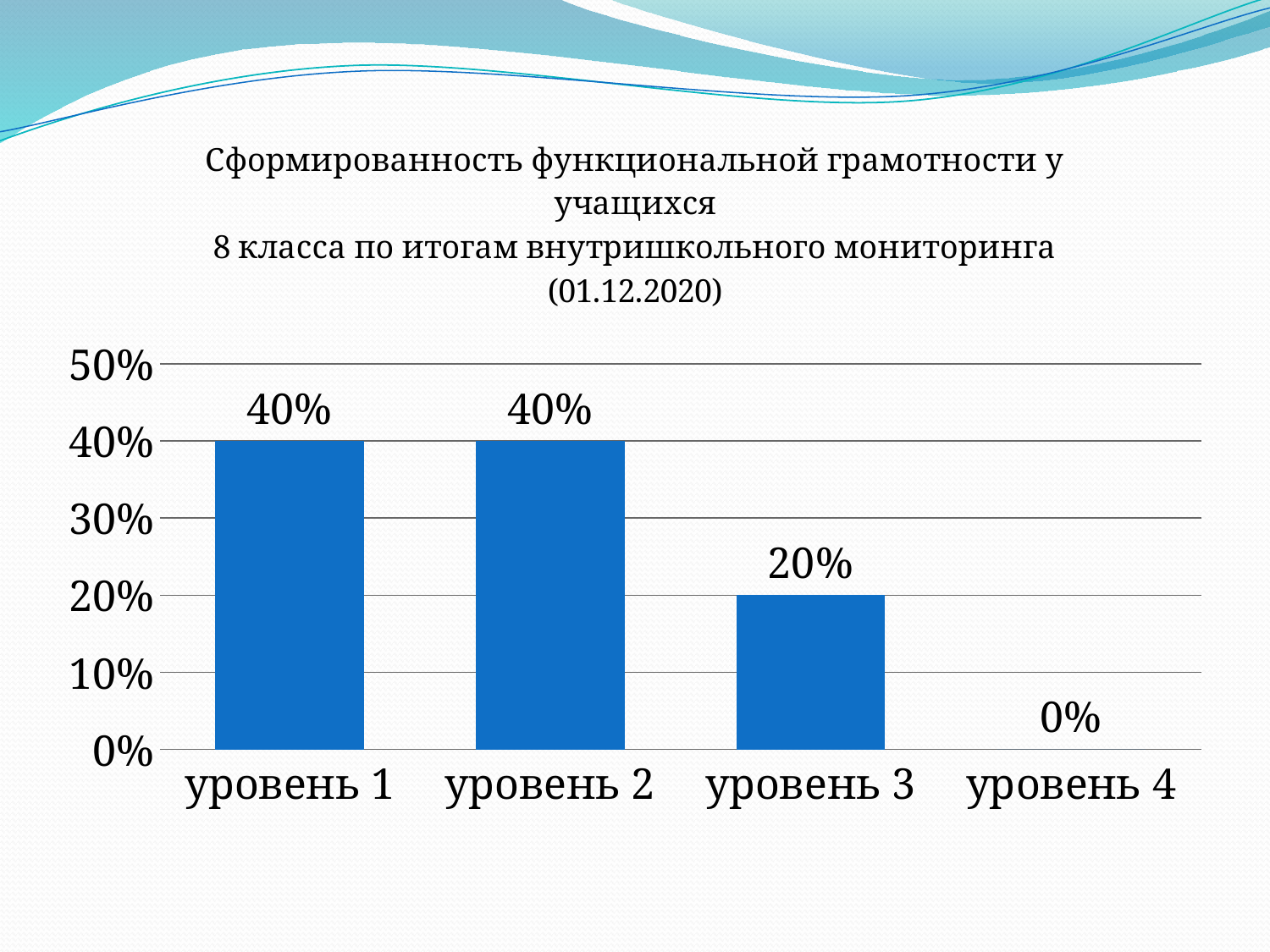
What is the highest value shown on the y axis? 50% Which is larger, the value for уровень 1 or the value for уровень 3? уровень 1 What date is given in the chart title? 01.12.2020 What is the difference between the values for уровень 2 and уровень 3? 20% What is the value for уровень 1? 40% What is the value for уровень 3? 20% Is the value for уровень 2 greater or less than 30%? greater Which category has the lowest value? уровень 4 What is the value for уровень 4? 0% Do the values rise or fall from уровень 2 to уровень 4? fall What kind of chart is shown on the slide? bar chart How many categories are shown on the x axis? 4